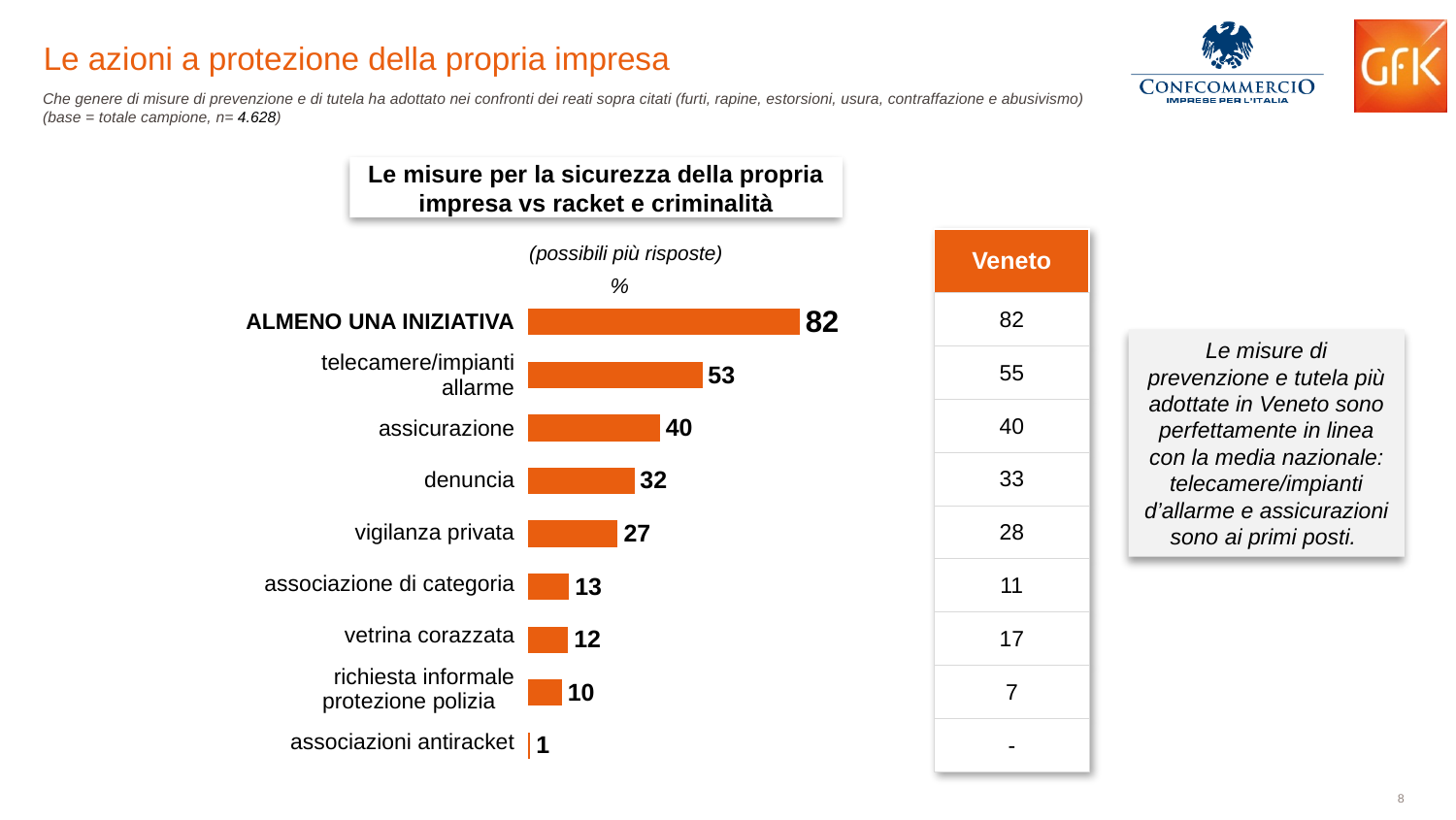
Which category has the lowest value in the bar chart? associazioni antiracket What kind of chart is shown on the slide? bar chart What is the difference between the values for 'assicurazione' and 'denuncia' in the bar chart? 8 What is the value for 'telecamere/impianti allarme' in the bar chart? 53 What is the difference between the values for 'ALMENO UNA INIZIATIVA' and 'telecamere/impianti allarme' in the bar chart? 29 How many categories are shown in the bar chart? 9 What is the value for 'associazioni antiracket' in the bar chart? 1 What colour are the bars in the chart? orange What is the value for 'vigilanza privata' in the bar chart? 27 Which category has the highest value in the bar chart? ALMENO UNA INIZIATIVA Which is larger in the bar chart: 'associazione di categoria' or 'vetrina corazzata'? associazione di categoria What is the title of the bar chart? Le misure per la sicurezza della propria impresa vs racket e criminalità